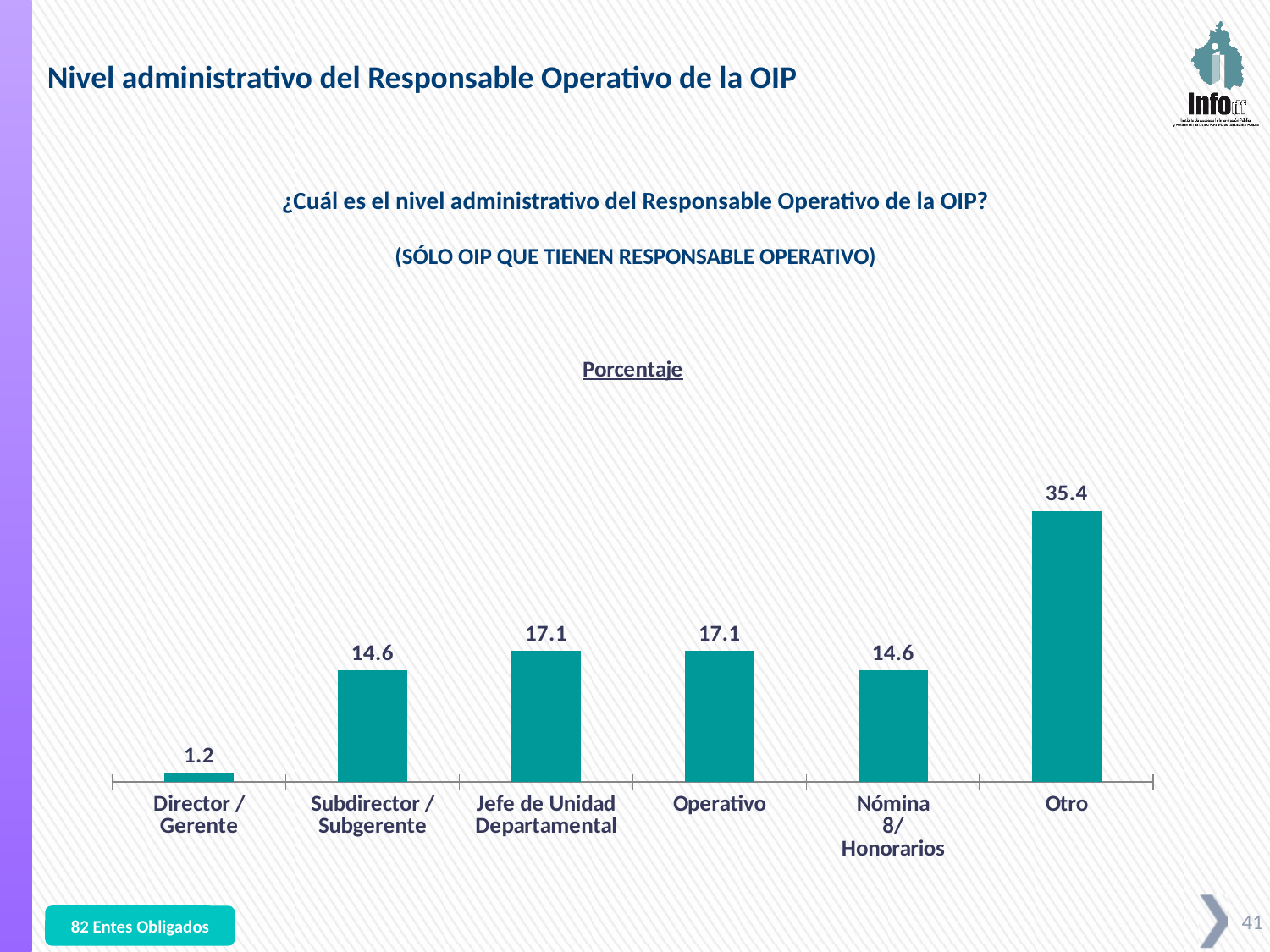
Which is larger, the value for Operativo or the value for Nómina 8/ Honorarios? Operativo What kind of chart is shown on the slide? Bar chart What is the value for Jefe de Unidad Departamental? 17.1 What is the title shown above the chart? Porcentaje What is the difference between the values for Otro and Operativo? 18.3 Which category has the lowest value? Director / Gerente What is the value for Nómina 8/ Honorarios? 14.6 Which category has the highest value? Otro What is the difference between the values for Subdirector / Subgerente and Director / Gerente? 13.4 How many categories are shown on the x axis? 6 What is the value for Director / Gerente? 1.2 What is the value for Otro? 35.4